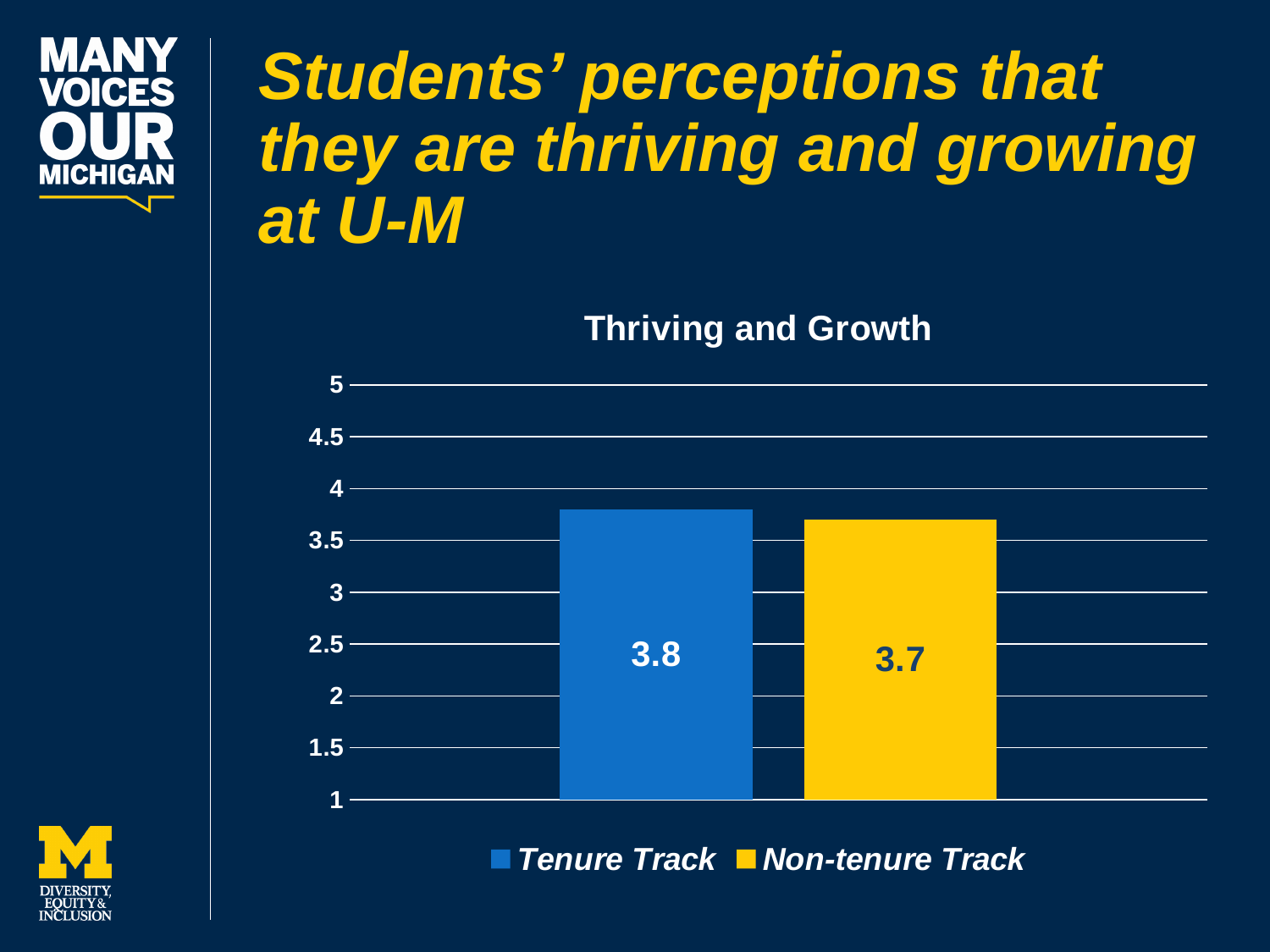
How many bars are plotted in the chart? 2 What is the value for Non-tenure Track in the Thriving and Growth chart? 3.7 How many series does the legend list? 2 Is the value for Tenure Track greater or less than 4? less Which series has the lower value in the Thriving and Growth chart? Non-tenure Track What kind of chart is shown on the slide? Bar chart What colour is the Non-tenure Track bar? Yellow What is the title of the chart? Thriving and Growth What is the value for Tenure Track in the Thriving and Growth chart? 3.8 Is the value for Non-tenure Track greater or less than 3.5? greater Which series has the higher value in the Thriving and Growth chart? Tenure Track What is the difference between the Tenure Track and Non-tenure Track values? 0.1